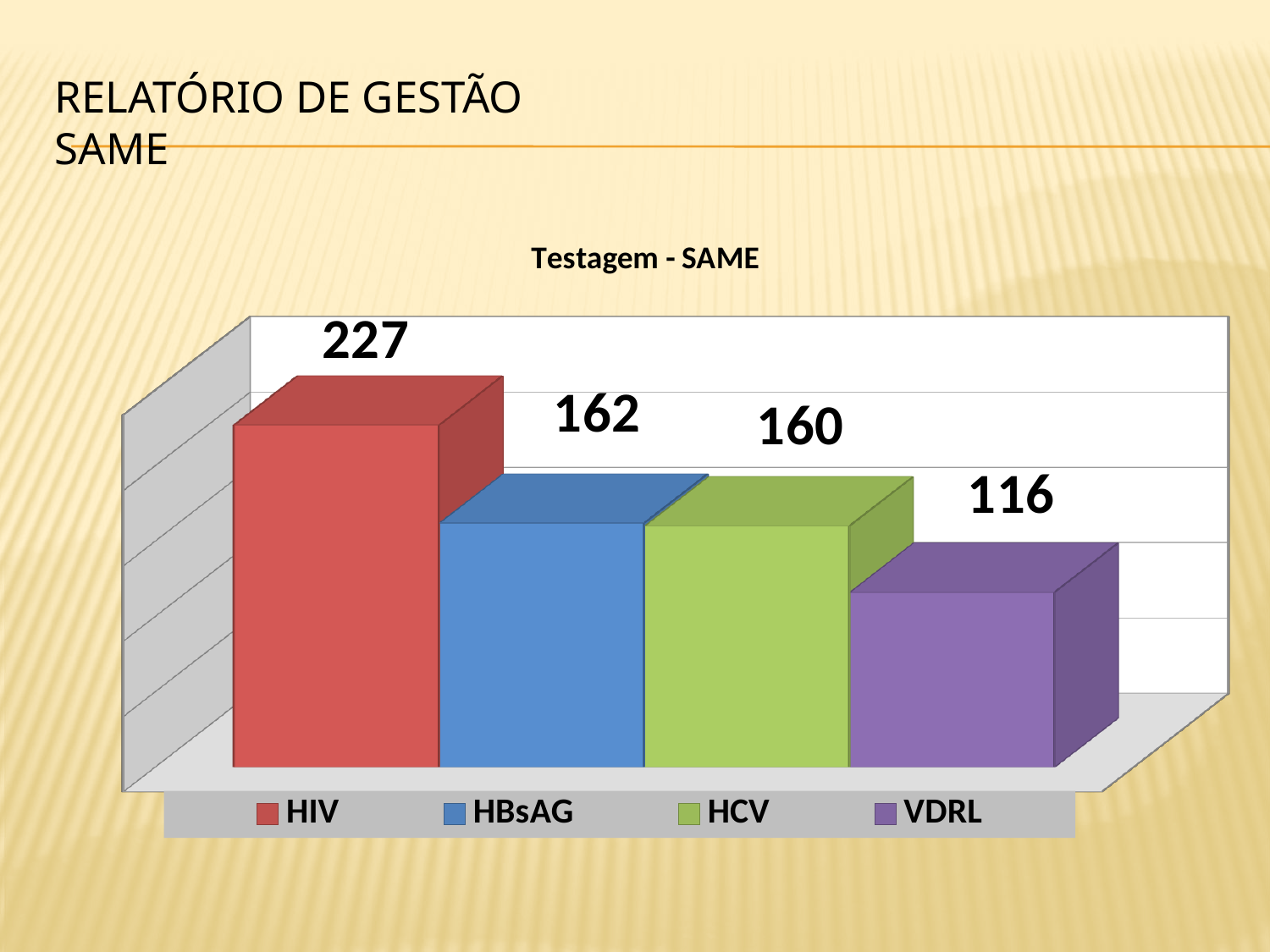
What is the difference between the HBsAG value and the HCV value? 2 How many tests are shown in the chart? 4 What is the difference between the HIV value and the VDRL value? 111 What is the title of the chart? Testagem - SAME What is the value for HIV in the Testagem - SAME chart? 227 What kind of chart is shown on the slide? Bar chart Which is larger, the value for HIV or the value for HBsAG? HIV What is the value for HCV? 160 What is the value for VDRL? 116 What is the value for HBsAG? 162 Which test has the highest value? HIV Which test has the lowest value? VDRL